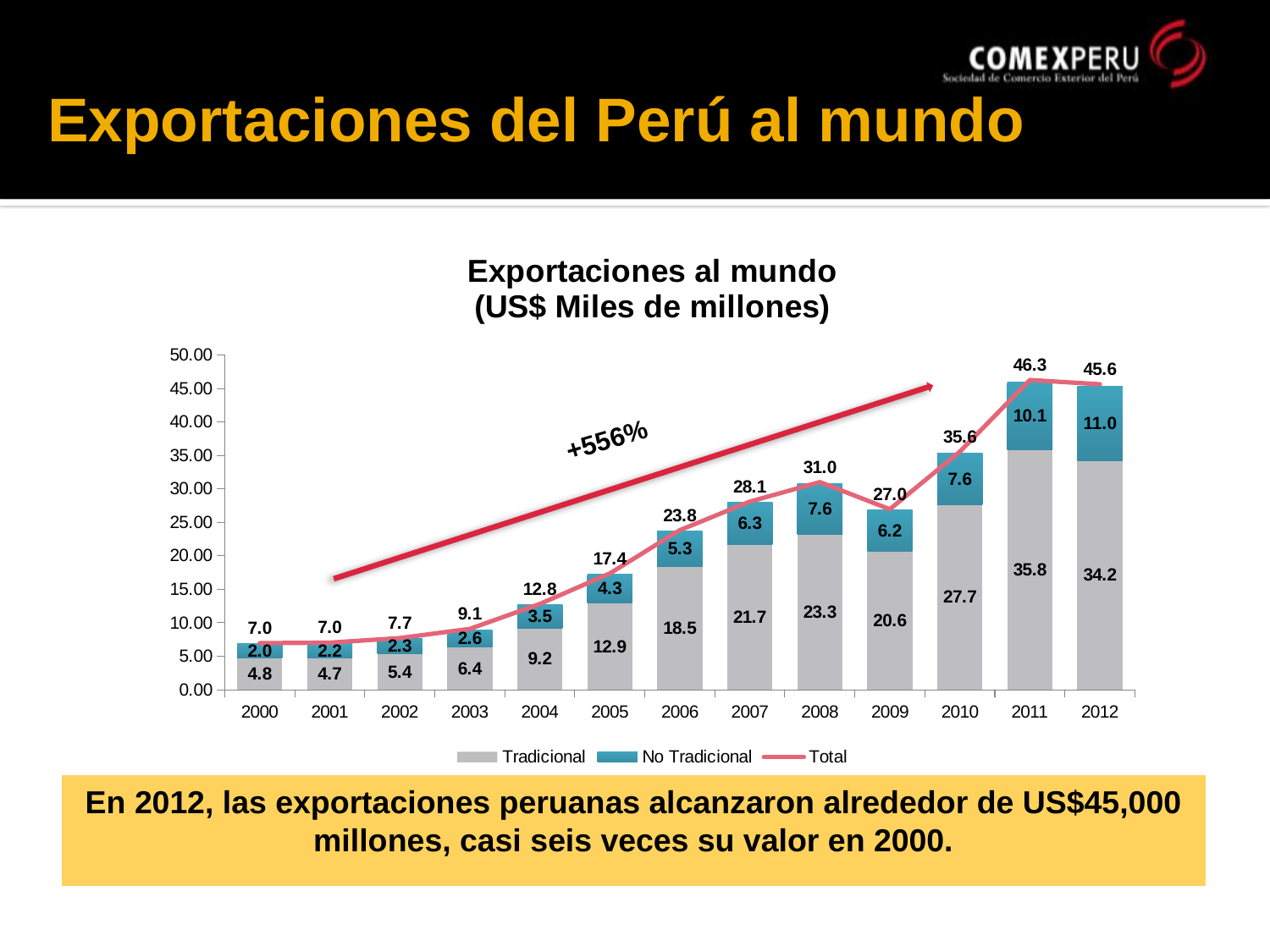
Which year has the highest Total export value? 2011 Which is larger, the No Tradicional value for 2009 or for 2010? 2010 What kind of chart is used to show the Tradicional and No Tradicional values? Stacked bar chart What is the Tradicional export value for 2012? 34.2 How many series does the legend list? 3 What is the No Tradicional export value for 2011? 10.1 Which year has the lowest Tradicional export value? 2001 What is the difference between the Total export values for 2011 and 2012? 0.7 What percentage growth is annotated on the chart? +556% Does the Total export value rise or fall from 2008 to 2009? Fall How many years are shown on the x axis? 13 What is the Total export value shown for 2008? 31.0